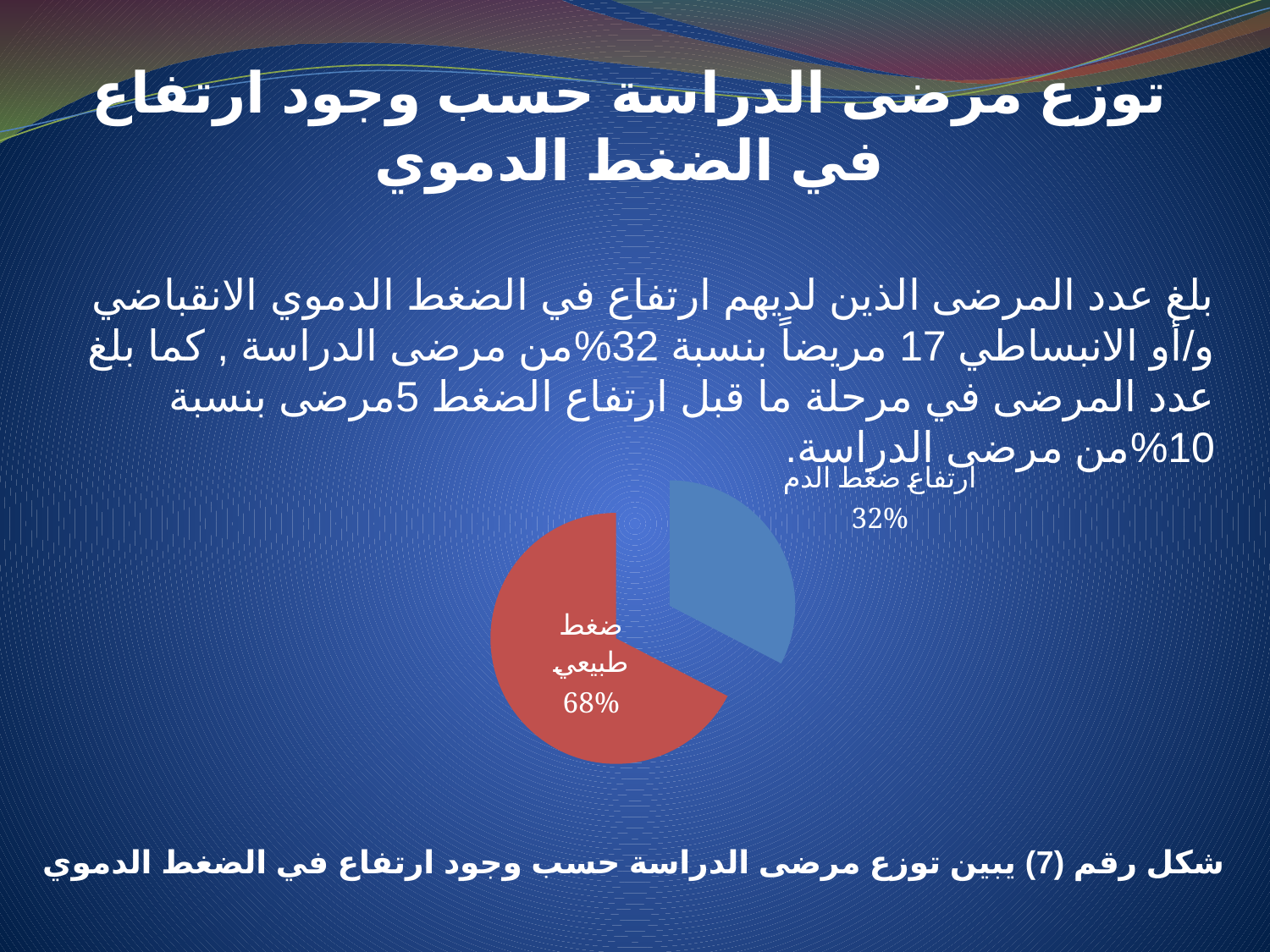
What colour is the slice labelled "ضغط طبيعي" in the pie chart? Red What share of the pie does the slice labelled "ضغط طبيعي" (normal blood pressure) represent? 68% How many slices does the pie chart have? 2 Which slice of the pie chart is the smallest? ارتفاع ضغط الدم What colour is the slice labelled "ارتفاع ضغط الدم" in the pie chart? Blue Which is larger: the share for "ارتفاع ضغط الدم" or the share for "ضغط طبيعي"? ضغط طبيعي What share of the pie does the slice labelled "ارتفاع ضغط الدم" (high blood pressure) represent? 32% What is the total of the two percentages shown on the pie chart? 100% What kind of chart is shown on the slide? Pie chart Which slice of the pie chart is the largest? ضغط طبيعي What is the difference in percentage points between the "ضغط طبيعي" slice and the "ارتفاع ضغط الدم" slice? 36